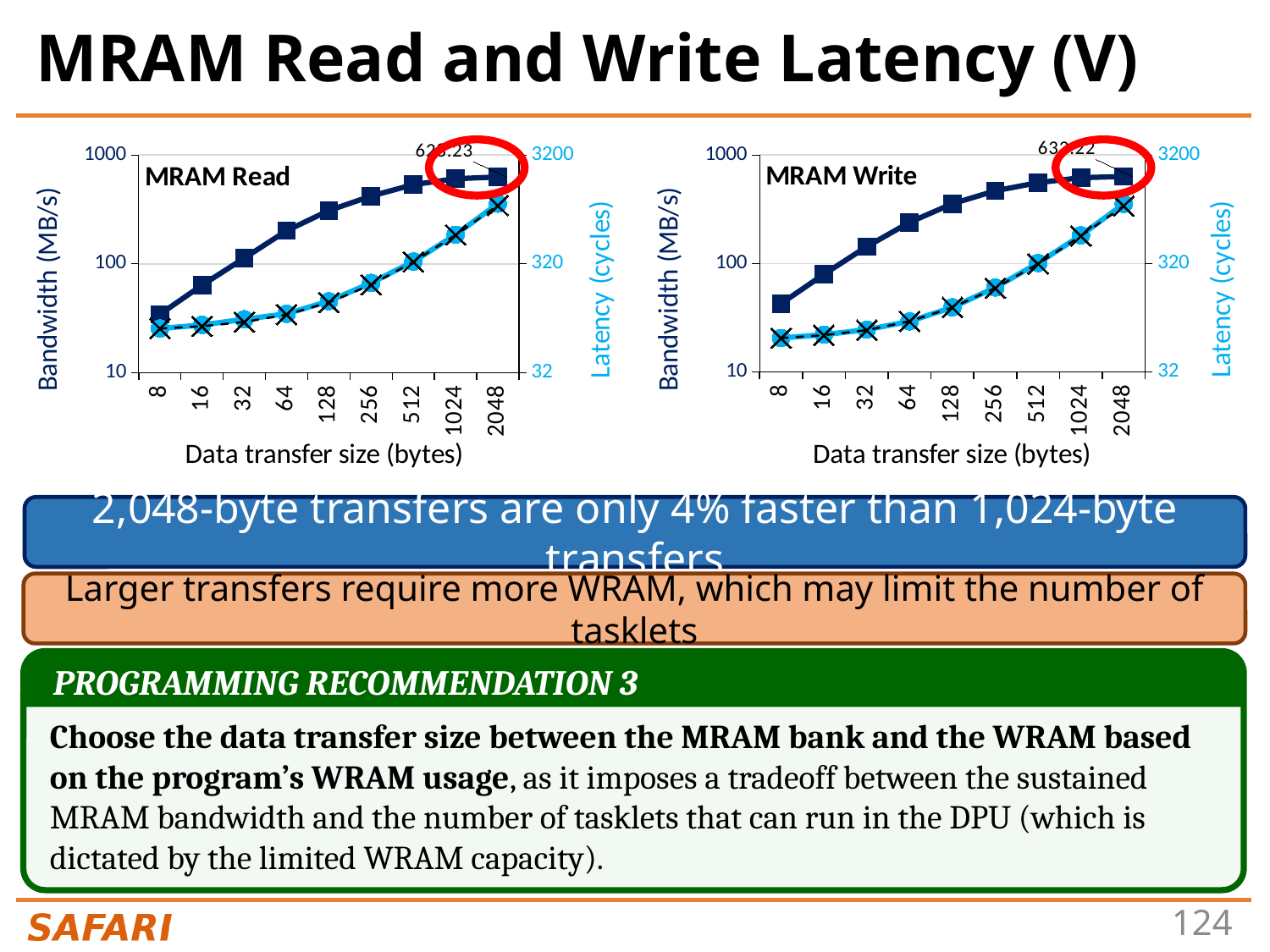
How many data transfer sizes are plotted on the x axis of the MRAM Write chart? 9 In the MRAM Read chart, is the bandwidth for a data transfer size of 8 bytes greater or less than 100 MB/s? less In the MRAM Read chart, is the latency for a data transfer size of 8 bytes greater or less than 320 cycles? less In the MRAM Read chart, which data transfer size has the highest bandwidth? 2048 What is the label of the right-hand y axis of the MRAM Write chart? Latency (cycles) In the MRAM Write chart, does latency rise or fall as the data transfer size increases? rise What is the x-axis title of the MRAM Read chart? Data transfer size (bytes) What kind of chart is the MRAM Read chart? line chart In the MRAM Write chart, which has the higher bandwidth: a data transfer size of 64 bytes or 8 bytes? 64 bytes In the MRAM Write chart, which data transfer size has the lowest bandwidth? 8 In the MRAM Read chart, does bandwidth rise or fall as the data transfer size increases? rise In the MRAM Write chart, is the bandwidth for a data transfer size of 2048 bytes greater or less than 100 MB/s? greater